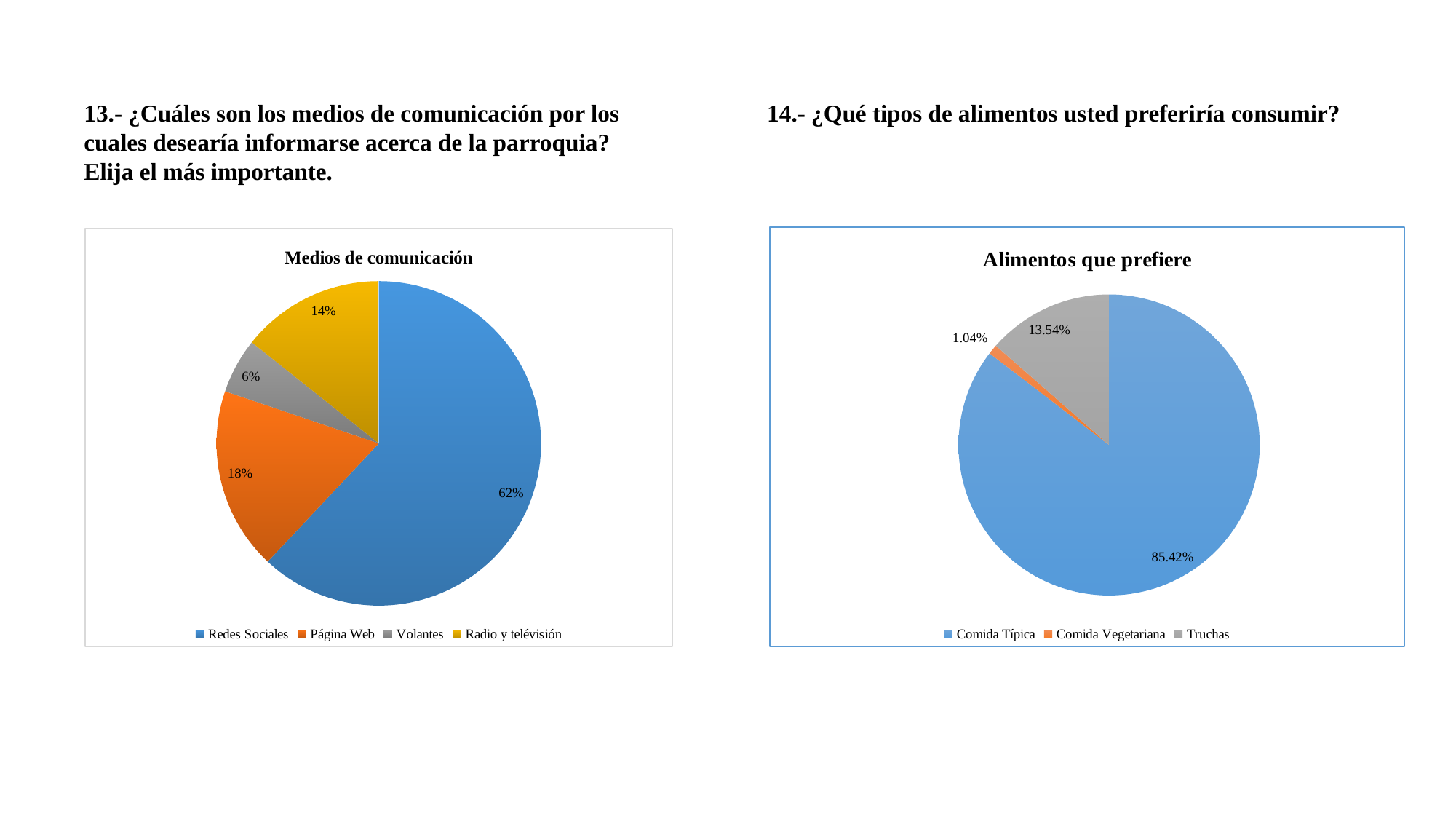
In the 'Medios de comunicación' chart, how many categories does the legend list? 4 In the 'Alimentos que prefiere' chart, what share does Comida Típica have? 85.42% In the 'Medios de comunicación' chart, what is the difference between Redes Sociales and Radio y telévisión? 48% In the 'Medios de comunicación' chart, what is the value for Volantes? 6% In the 'Alimentos que prefiere' chart, which category has the smallest slice? Comida Vegetariana In the 'Alimentos que prefiere' chart, what is the value for Truchas? 13.54% In the 'Medios de comunicación' chart, which category has the smallest slice? Volantes In the 'Medios de comunicación' chart, what share does Redes Sociales have? 62% In the 'Medios de comunicación' chart, what is the value for Página Web? 18% In the 'Alimentos que prefiere' chart, what colour is the Comida Típica slice? Blue In the 'Alimentos que prefiere' chart, which is larger, Truchas or Comida Vegetariana? Truchas What kind of chart is 'Alimentos que prefiere'? Pie chart